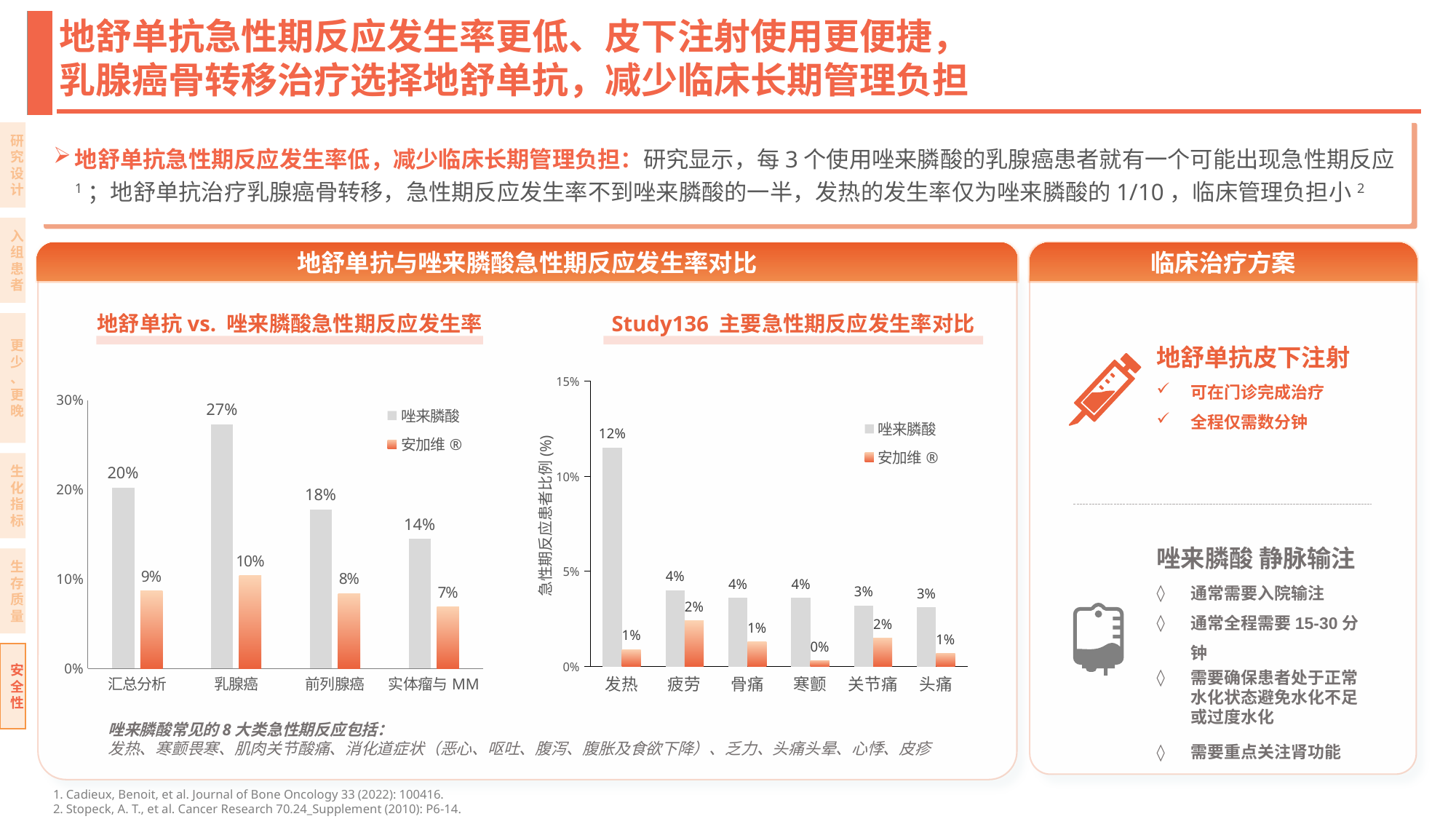
In the chart titled '地舒单抗 vs. 唑来膦酸急性期反应发生率', what is the difference between the 唑来膦酸 and 安加维 ® values in the 乳腺癌 category? 17% In the chart titled 'Study136 主要急性期反应发生率对比', which category has the highest value for 唑来膦酸? 发热 In the chart titled '地舒单抗 vs. 唑来膦酸急性期反应发生率', which category has the highest value for 唑来膦酸? 乳腺癌 In the chart titled 'Study136 主要急性期反应发生率对比', what is the value for 唑来膦酸 in the 发热 category? 12% In the chart titled '地舒单抗 vs. 唑来膦酸急性期反应发生率', what is the value for 安加维 ® in the 汇总分析 category? 9% In the chart titled 'Study136 主要急性期反应发生率对比', what is the value for 安加维 ® in the 寒颤 category? 0% In the chart titled 'Study136 主要急性期反应发生率对比', how many series does the legend list? 2 What kind of chart is the chart titled 'Study136 主要急性期反应发生率对比'? bar chart In the chart titled '地舒单抗 vs. 唑来膦酸急性期反应发生率', which category has the lowest value for 安加维 ®? 实体瘤与 MM In the chart titled '地舒单抗 vs. 唑来膦酸急性期反应发生率', how many categories are shown on the x axis? 4 In the chart titled '地舒单抗 vs. 唑来膦酸急性期反应发生率', what is the value for 唑来膦酸 in the 乳腺癌 category? 27% In the chart titled 'Study136 主要急性期反应发生率对比', is the 唑来膦酸 value for 发热 greater or less than 10%? greater